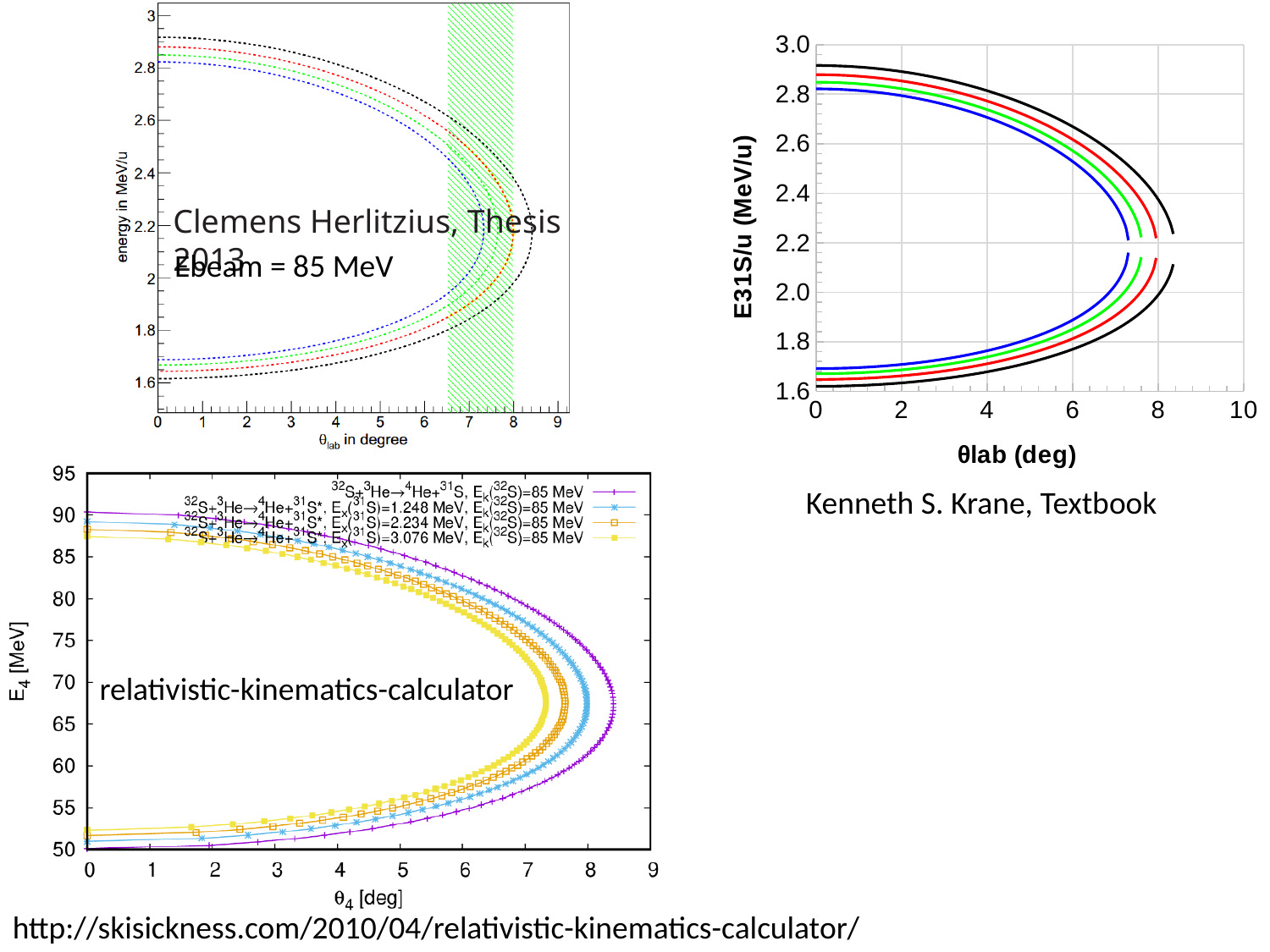
In the top-right chart, which curve extends to the larger lab angle, the black curve or the blue curve? black In the top-right chart, is the maximum energy of the black curve greater or less than 2.8 MeV/u? greater How many series does the legend of the bottom-left chart list? 4 What kind of chart is the bottom-left chart labelled relativistic-kinematics-calculator? line chart In the bottom-left chart, is the maximum angle reached by the yellow curve greater or less than 8 degrees? less In the top-right chart, is the minimum energy of the black curve greater or less than 1.8 MeV/u? less What beam energy is stated on the top-left chart (Clemens Herlitzius, Thesis)? Ebeam = 85 MeV How many curves are plotted in the top-left chart (Clemens Herlitzius, Thesis)? 4 What is the x-axis label of the top-right chart (Kenneth S. Krane, Textbook)? θlab (deg) In the top-right chart, along the upper branch of the curves, does the energy rise or fall as the lab angle increases? fall